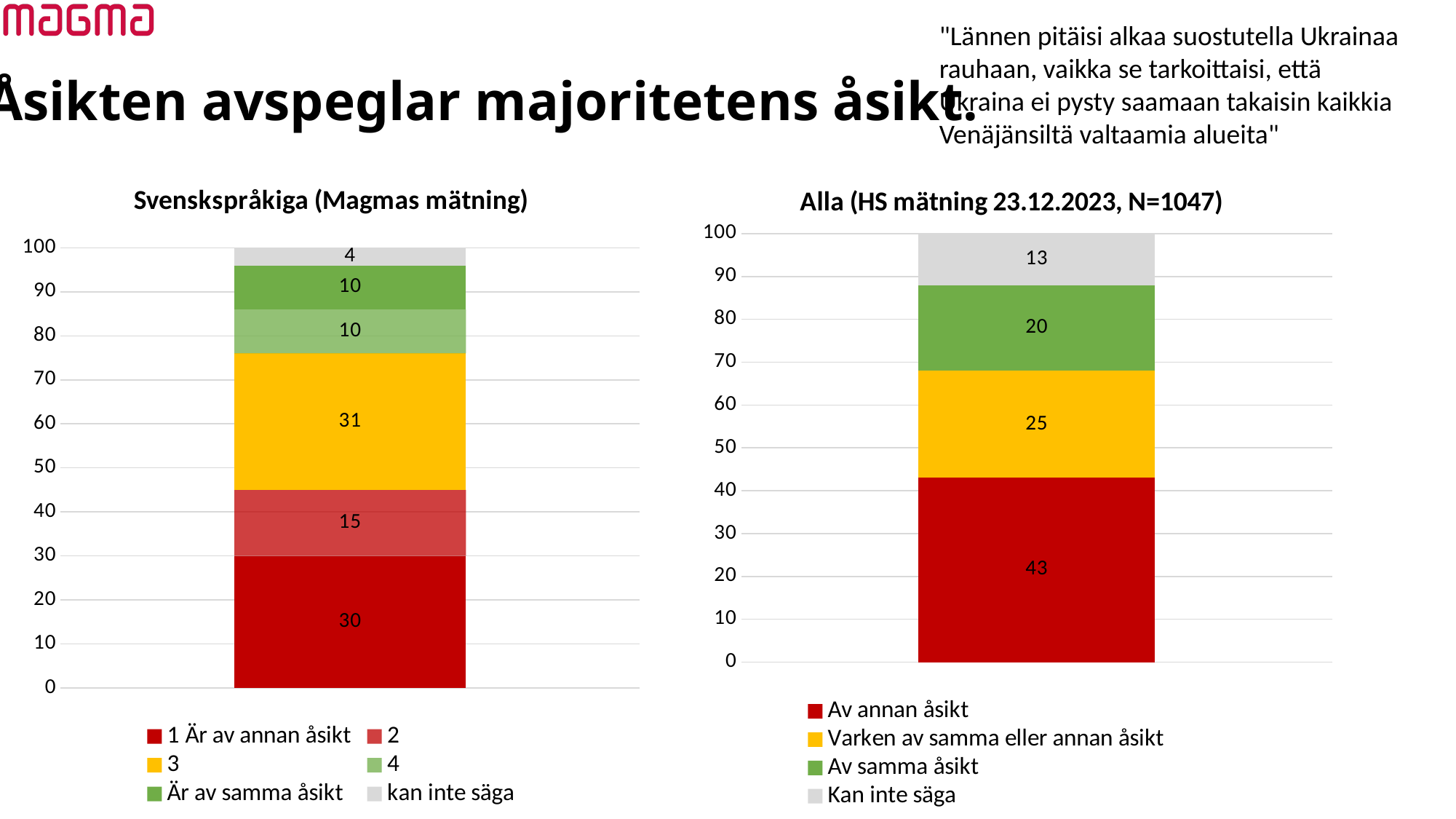
In the chart titled "Alla (HS mätning 23.12.2023, N=1047)", which series has the largest value? Av annan åsikt In the chart titled "Alla (HS mätning 23.12.2023, N=1047)", what is the value for "Kan inte säga"? 13 In the chart titled "Alla (HS mätning 23.12.2023, N=1047)", what is the difference between "Av annan åsikt" and "Av samma åsikt"? 23 How many series does the legend of the chart titled "Svenskspråkiga (Magmas mätning)" list? 6 In the chart titled "Svenskspråkiga (Magmas mätning)", which is larger: the value for "3" or the value for "2"? 3 What kind of chart is the chart titled "Alla (HS mätning 23.12.2023, N=1047)"? Stacked bar chart In the chart titled "Svenskspråkiga (Magmas mätning)", what is the value for "1 Är av annan åsikt"? 30 In the chart titled "Svenskspråkiga (Magmas mätning)", what is the value for "kan inte säga"? 4 In the chart titled "Alla (HS mätning 23.12.2023, N=1047)", what is the value for "Av annan åsikt"? 43 In the chart titled "Svenskspråkiga (Magmas mätning)", what is the value for "3"? 31 How many series does the legend of the chart titled "Alla (HS mätning 23.12.2023, N=1047)" list? 4 In the chart titled "Svenskspråkiga (Magmas mätning)", which series has the smallest value? kan inte säga